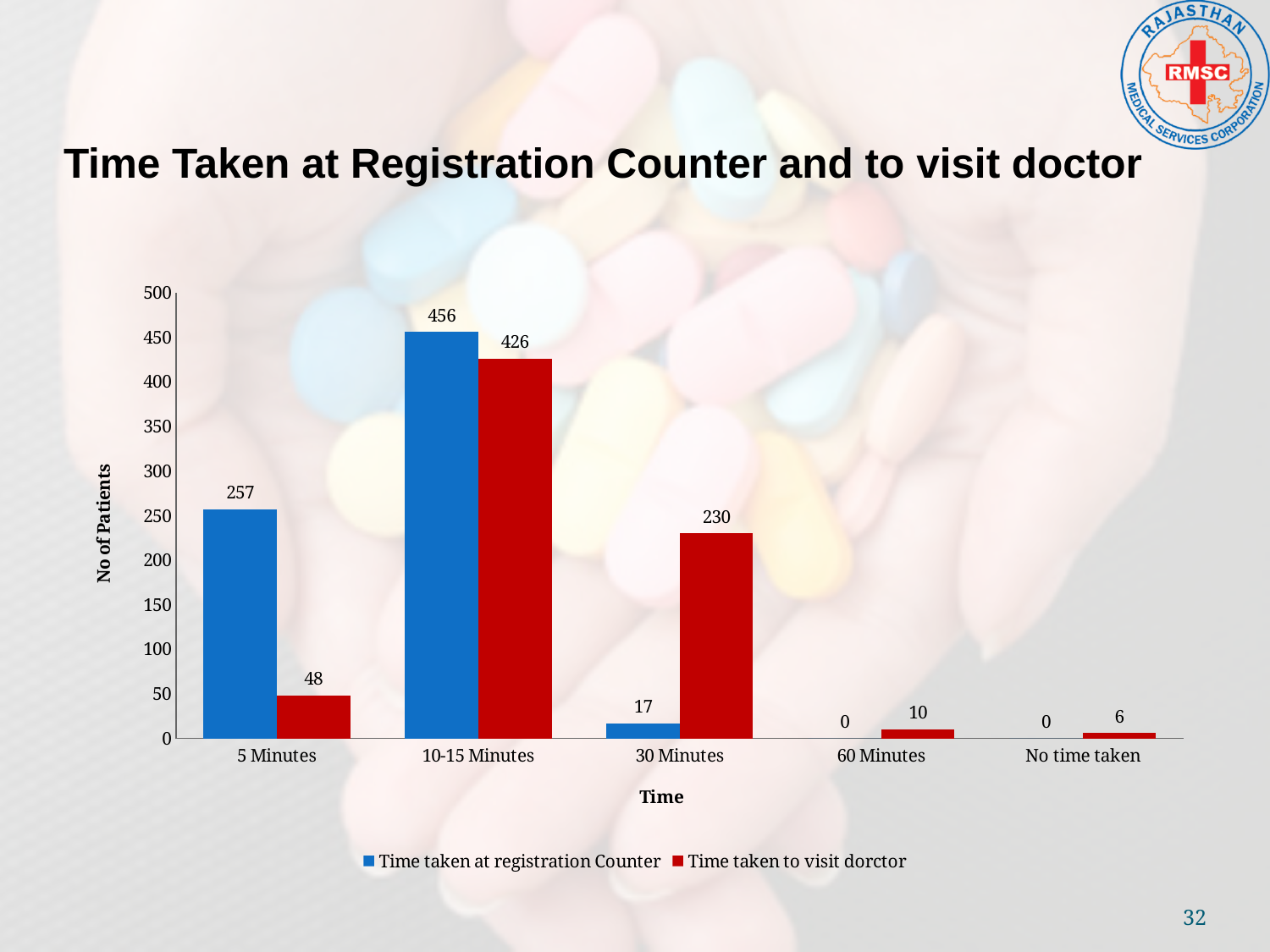
How many series does the legend list? 2 Is the value for 'Time taken to visit dorctor' at 10-15 Minutes greater or less than 400? greater What is the value for 'Time taken to visit dorctor' at 30 Minutes? 230 What is the value for 'Time taken at registration Counter' at 5 Minutes? 257 What is the value for 'Time taken to visit dorctor' at 60 Minutes? 10 What kind of chart is shown on the slide? Bar chart What is the difference between the two series at 10-15 Minutes? 30 At 5 Minutes, which series has the larger value? Time taken at registration Counter How many time categories are shown on the x axis? 5 What is the label of the y axis? No of Patients Which time category has the lowest value for 'Time taken to visit dorctor'? No time taken Which time category has the highest value for 'Time taken at registration Counter'? 10-15 Minutes